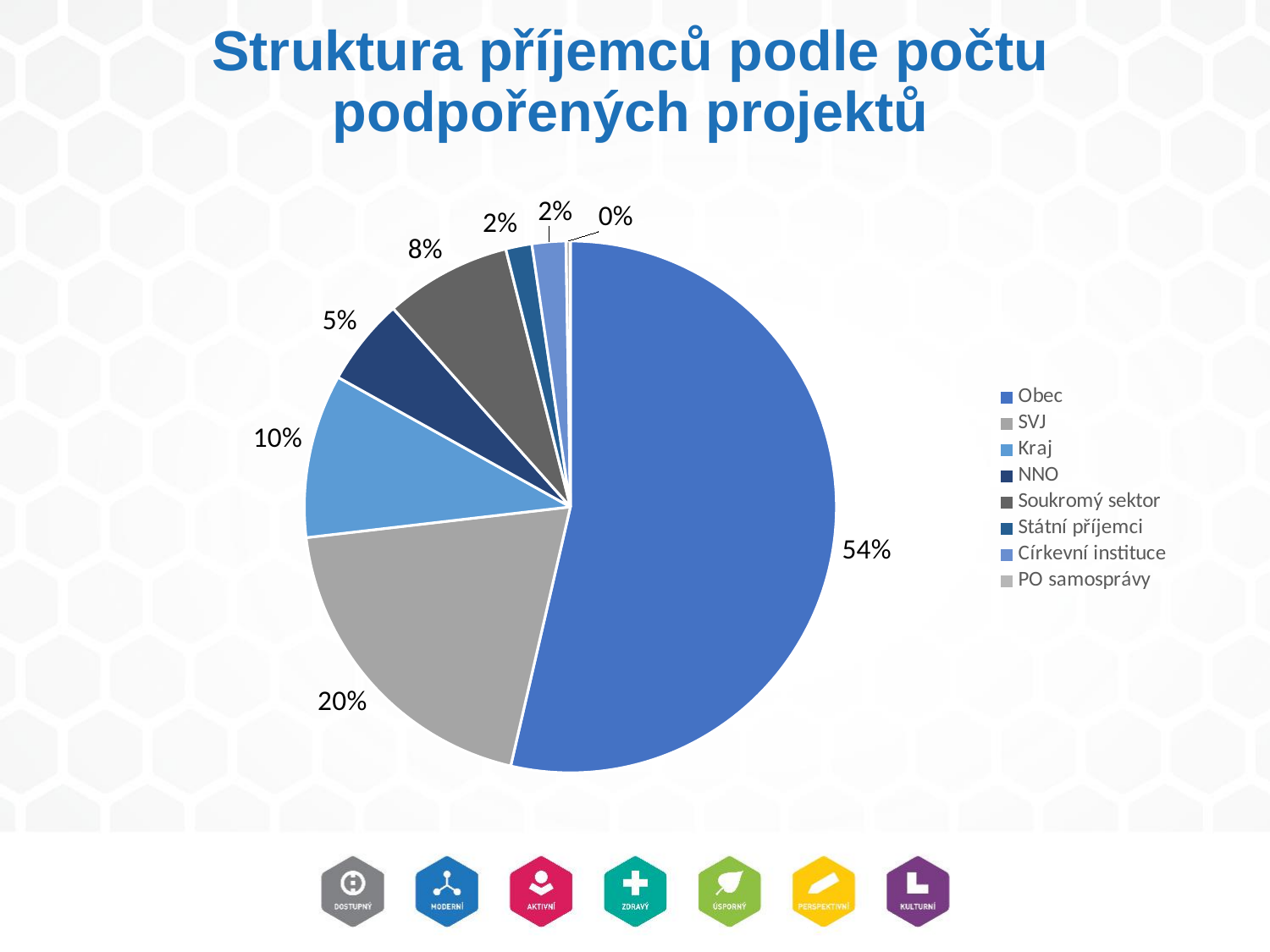
How many categories does the legend list? 8 What share of the pie does SVJ hold? 20% What kind of chart is shown on the slide? Pie chart Which category has the smallest share of the pie? PO samosprávy Which has a larger share, Kraj or Soukromý sektor? Kraj Which category has the largest share of the pie? Obec What share of the pie does PO samosprávy hold? 0% What is the difference in percentage points between the shares of Obec and SVJ? 34 What share of the pie does Kraj hold? 10%